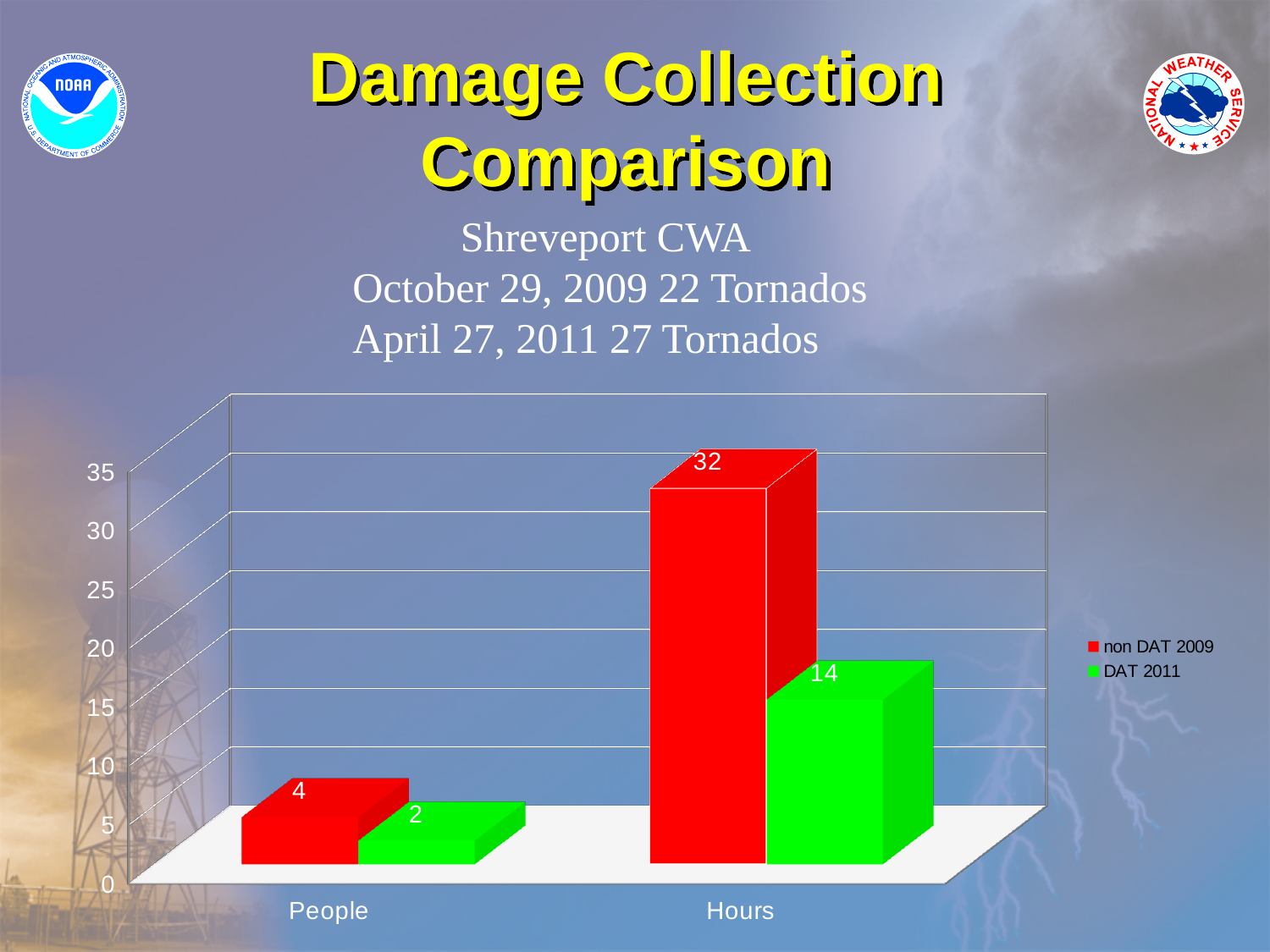
What kind of chart is shown on the slide? Bar chart What colour represents the DAT 2011 series? Green What is the value for non DAT 2009 in the People category? 4 What is the value for DAT 2011 in the Hours category? 14 Which is larger in the People category, non DAT 2009 or DAT 2011? non DAT 2009 Which category has the lowest value for DAT 2011? People What is the value for non DAT 2009 in the Hours category? 32 How many series does the legend list? 2 How many categories are shown on the x axis? 2 Which category has the highest value for non DAT 2009? Hours What is the difference between non DAT 2009 and DAT 2011 in the Hours category? 18 What is the value for DAT 2011 in the People category? 2